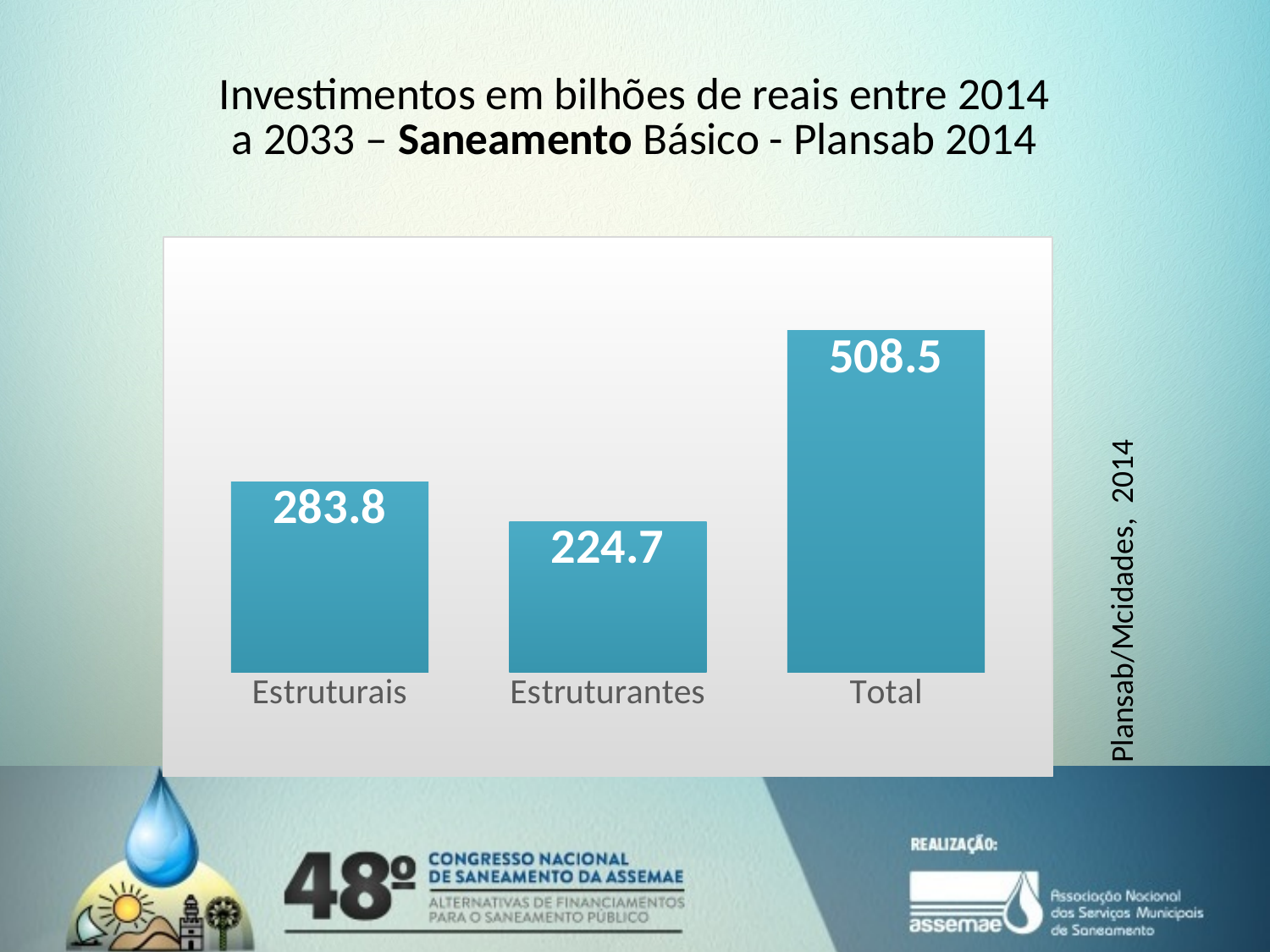
Which category has the highest value? Total What source is cited beside the chart? Plansab/Mcidades, 2014 Which category has the lowest value? Estruturantes What is the title of the chart on the slide? Investimentos em bilhões de reais entre 2014 a 2033 – Saneamento Básico - Plansab 2014 What is the value for Total? 508.5 What is the value for Estruturais? 283.8 Which is larger, the value for Estruturais or the value for Estruturantes? Estruturais What is the difference between the values for Total and Estruturais? 224.7 How many categories are shown in the chart? 3 What is the difference between the values for Estruturais and Estruturantes? 59.1 What is the value for Estruturantes? 224.7 What kind of chart is shown on the slide? bar chart